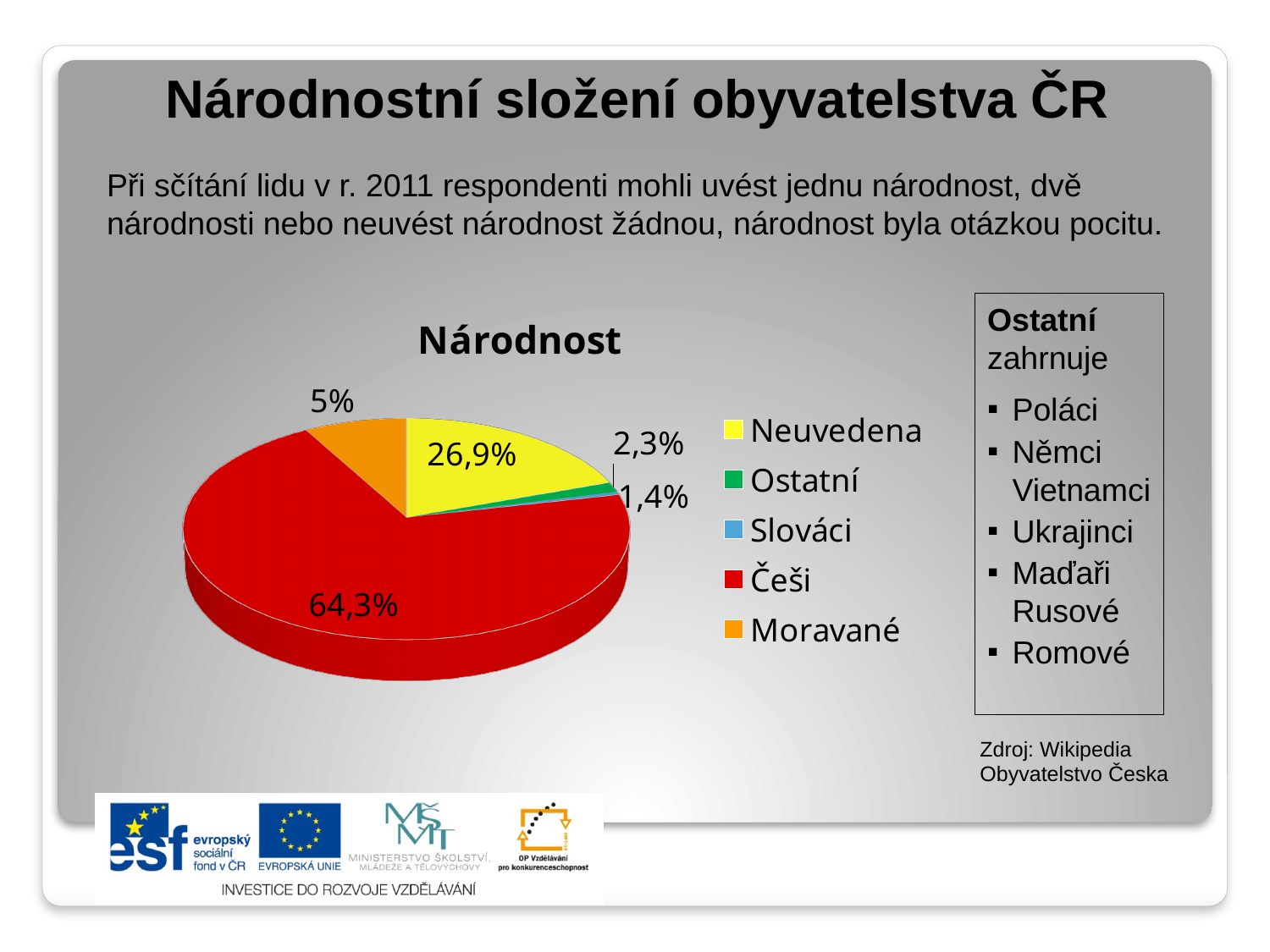
Which category has the largest slice of the pie? Češi What share of the pie is Moravané? 5% How many slices does the pie chart have? 5 What is the difference in percentage points between Češi and Neuvedena? 37,4 What kind of chart is shown on the slide? pie chart What is the title of the chart? Národnost What share of the pie is Slováci? 1,4% How many entries does the chart legend list? 5 What share of the pie is Neuvedena? 26,9% Which category has the smallest slice of the pie? Slováci